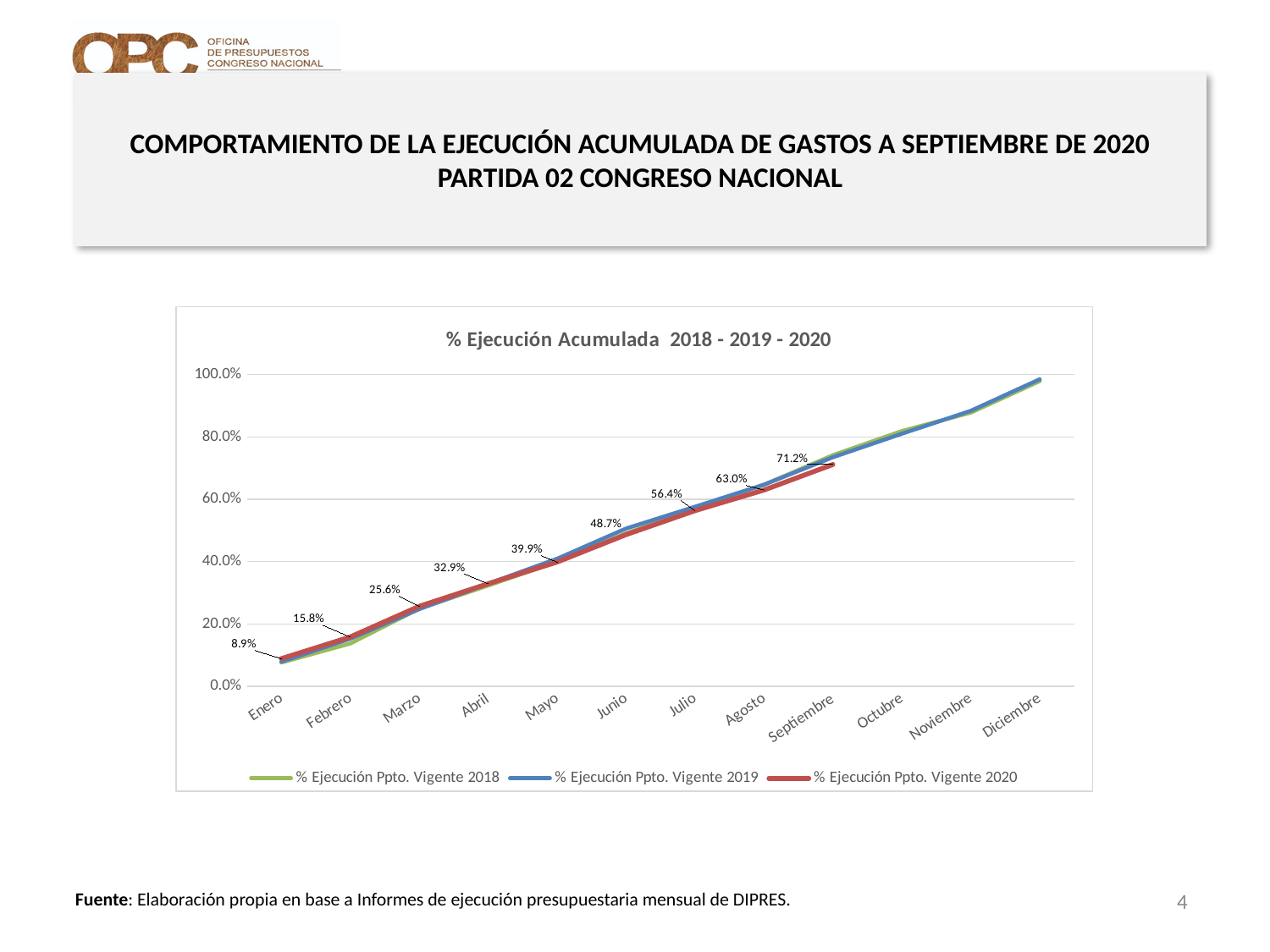
What is the value of % Ejecución Ppto. Vigente 2020 for Septiembre? 71.2% What is the difference between the % Ejecución Ppto. Vigente 2020 values for Septiembre and Agosto? 8.2% What kind of chart is shown on the slide? Line chart Is the value of % Ejecución Ppto. Vigente 2019 for Diciembre greater or less than 80.0%? greater In which month does the % Ejecución Ppto. Vigente 2020 series reach its highest value? Septiembre How many series does the legend list? 3 In which month does the % Ejecución Ppto. Vigente 2020 series have its lowest value? Enero What is the value of % Ejecución Ppto. Vigente 2020 for Julio? 56.4% How many months are shown on the x axis? 12 What is the value of % Ejecución Ppto. Vigente 2020 for Enero? 8.9% What is the value of % Ejecución Ppto. Vigente 2020 for Mayo? 39.9% What is the difference between the % Ejecución Ppto. Vigente 2020 values for Marzo and Febrero? 9.8%